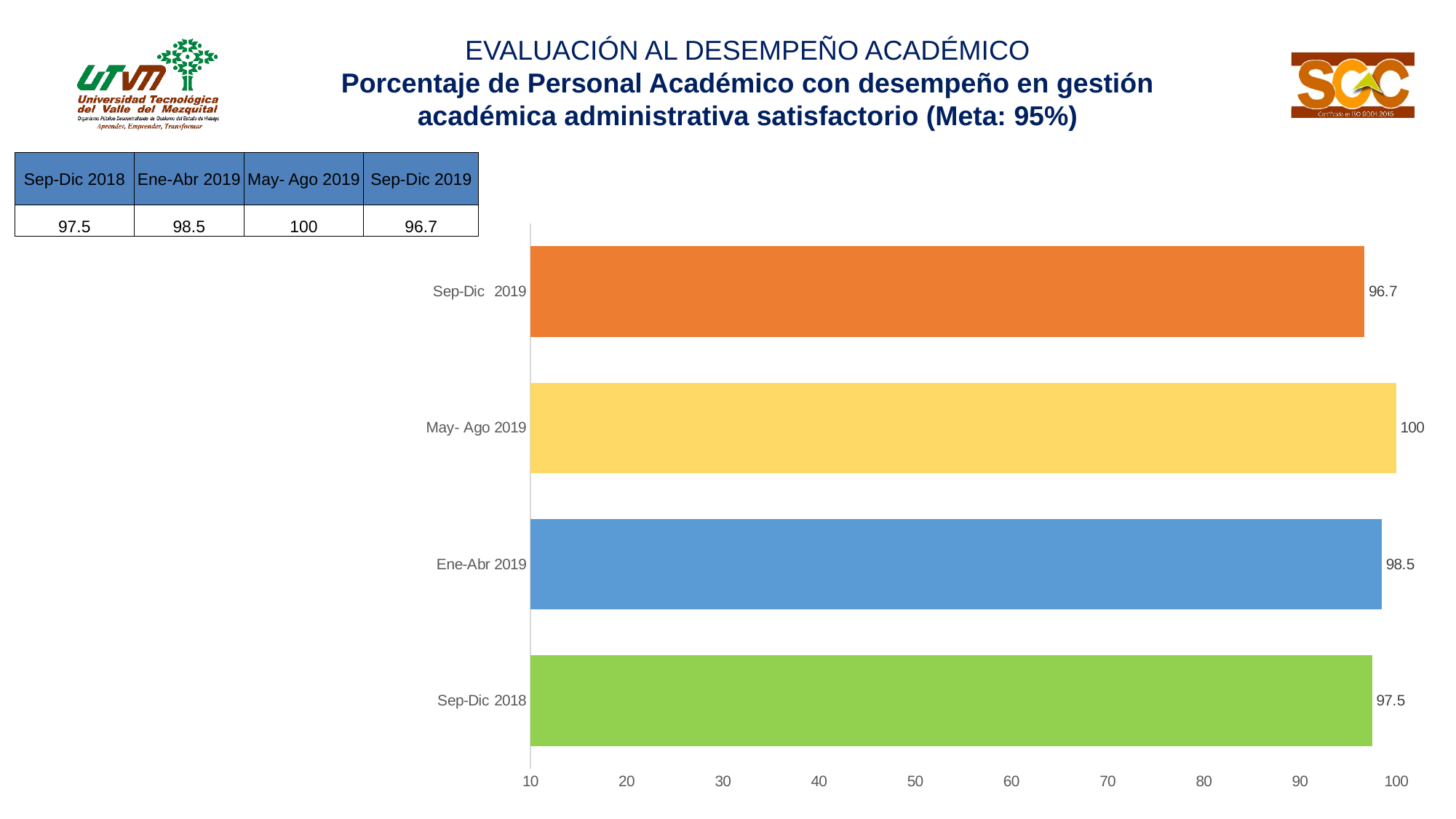
How many periods are shown in the chart? 4 What is the value for Sep-Dic 2019? 96.7 What is the difference between the values for May- Ago 2019 and Sep-Dic 2019? 3.3 What is the value for Sep-Dic 2018? 97.5 What is the difference between the values for Ene-Abr 2019 and Sep-Dic 2018? 1 Which is larger, the value for Ene-Abr 2019 or the value for Sep-Dic 2018? Ene-Abr 2019 Is the value for Sep-Dic 2019 greater or less than 90? greater Which period has the highest value? May- Ago 2019 What kind of chart is shown on the slide? bar chart Which period has the lowest value? Sep-Dic 2019 What is the value for May- Ago 2019? 100 What is the value for Ene-Abr 2019? 98.5